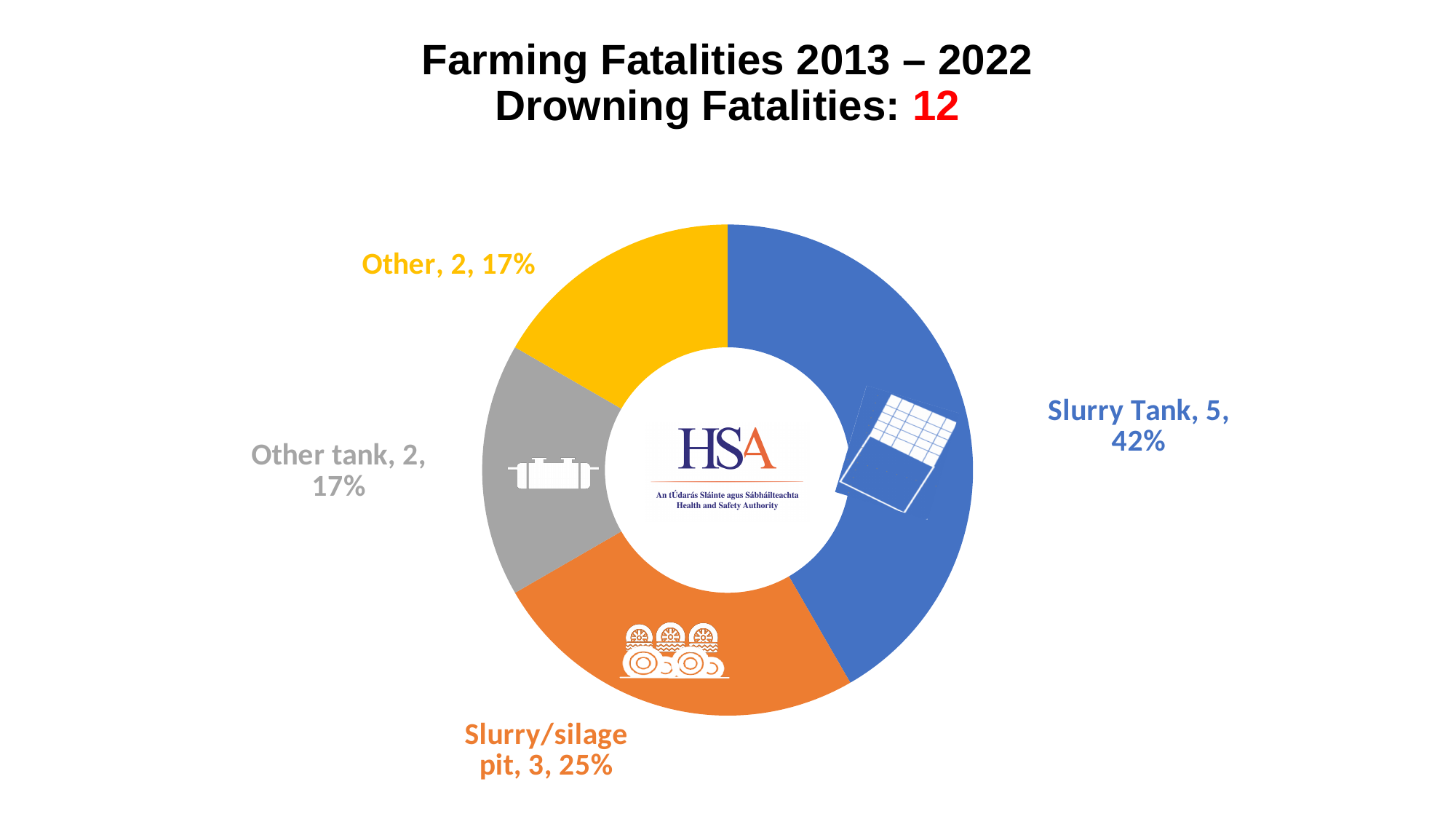
Which has more fatalities, Slurry/silage pit or Other tank? Slurry/silage pit Which category accounts for the largest share of drowning fatalities? Slurry Tank What share of the pie does the Other category represent? 17% What percentage of drowning fatalities is attributed to Slurry/silage pit? 25% What is the difference in fatalities between Slurry Tank and Slurry/silage pit? 2 What is the title of the chart? Farming Fatalities 2013 – 2022 Drowning Fatalities: 12 What kind of chart is shown on the slide? Pie chart (doughnut) What is the total number of drowning fatalities shown in the chart? 12 What colour is the Slurry Tank slice? Blue How many drowning fatalities are attributed to Slurry Tank? 5 How many drowning fatalities are attributed to Other tank? 2 How many categories are shown in the chart? 4